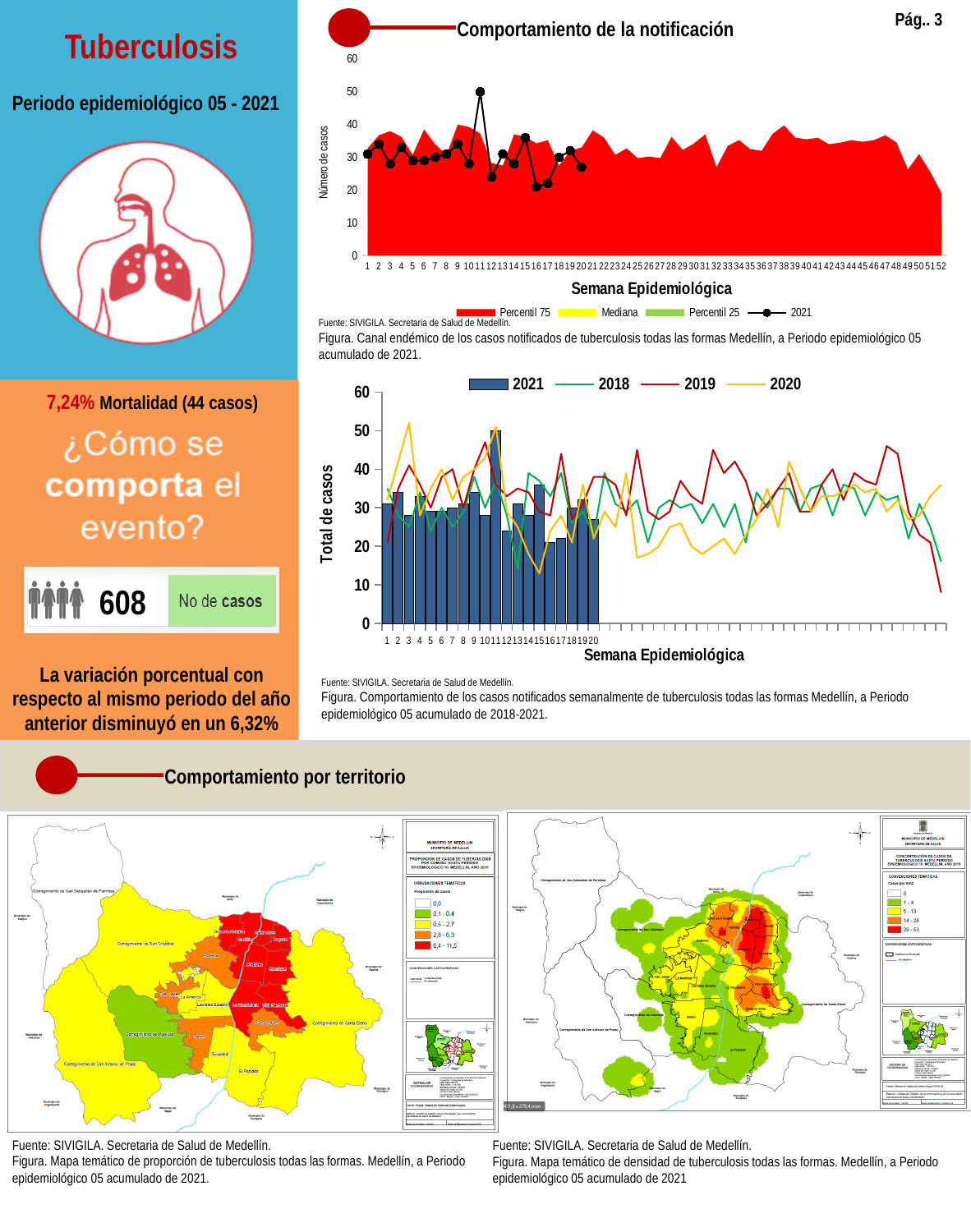
In the top chart (Comportamiento de la notificación), is the 2021 value at week 11 greater or less than 40? greater In the top chart (Comportamiento de la notificación), does the 2021 line rise or fall from week 11 to week 12? fall In the top chart (Comportamiento de la notificación), is the 2021 value at week 16 greater or less than 30? less In the bottom chart (Total de casos by Semana Epidemiológica), how many series does the legend list? 4 In the bottom chart (Total de casos by Semana Epidemiológica), is the 2021 bar for week 17 greater or less than 30? less In the top chart (Comportamiento de la notificación), how many series does the legend list? 4 In the bottom chart (Total de casos by Semana Epidemiológica), which week has the highest 2021 bar? Week 11 In the top chart (Comportamiento de la notificación), what is the label of the x axis? Semana Epidemiológica In the bottom chart (Total de casos by Semana Epidemiológica), how many bars are plotted for 2021? 20 In the top chart (Comportamiento de la notificación), what colour is the Percentil 75 series? Red In the bottom chart (Total de casos by Semana Epidemiológica), what kind of chart is used to show the 2021 series? Bar chart